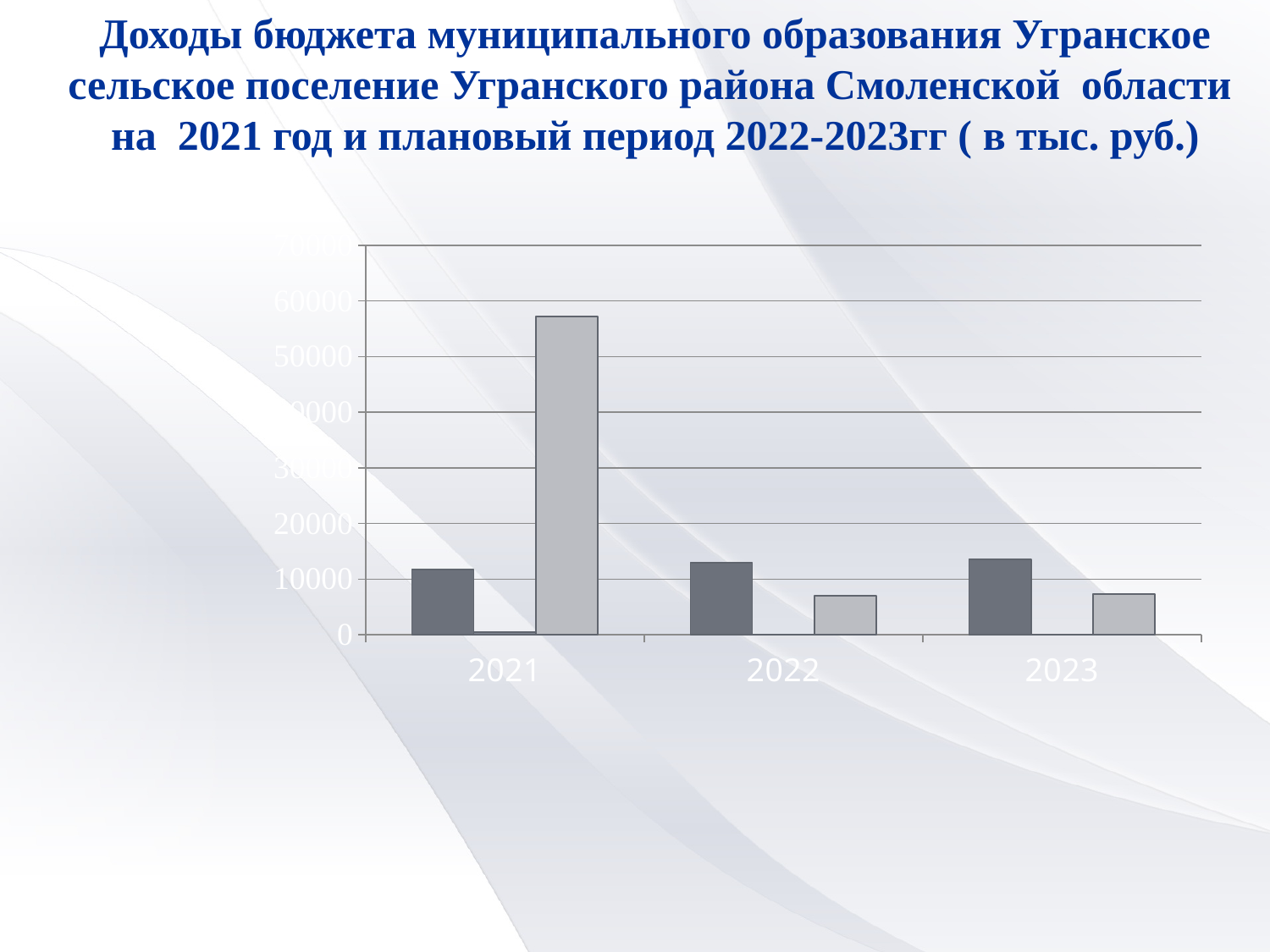
How many years are shown along the x axis of the chart? 3 Is the value of the light gray bar for 2022 greater or less than 10000? less Which year contains the tallest bar in the chart? 2021 In which year is the dark gray bar the lowest? 2021 In 2021, which bar is taller: the dark gray bar or the light gray bar? the light gray bar Is the value of the dark gray bar for 2021 greater or less than 10000? greater What kind of chart is shown on the slide? bar chart Is the value of the dark gray bar for 2023 greater or less than 10000? greater In 2022, which bar is taller: the dark gray bar or the light gray bar? the dark gray bar Which years are listed along the x axis of the chart? 2021, 2022, 2023